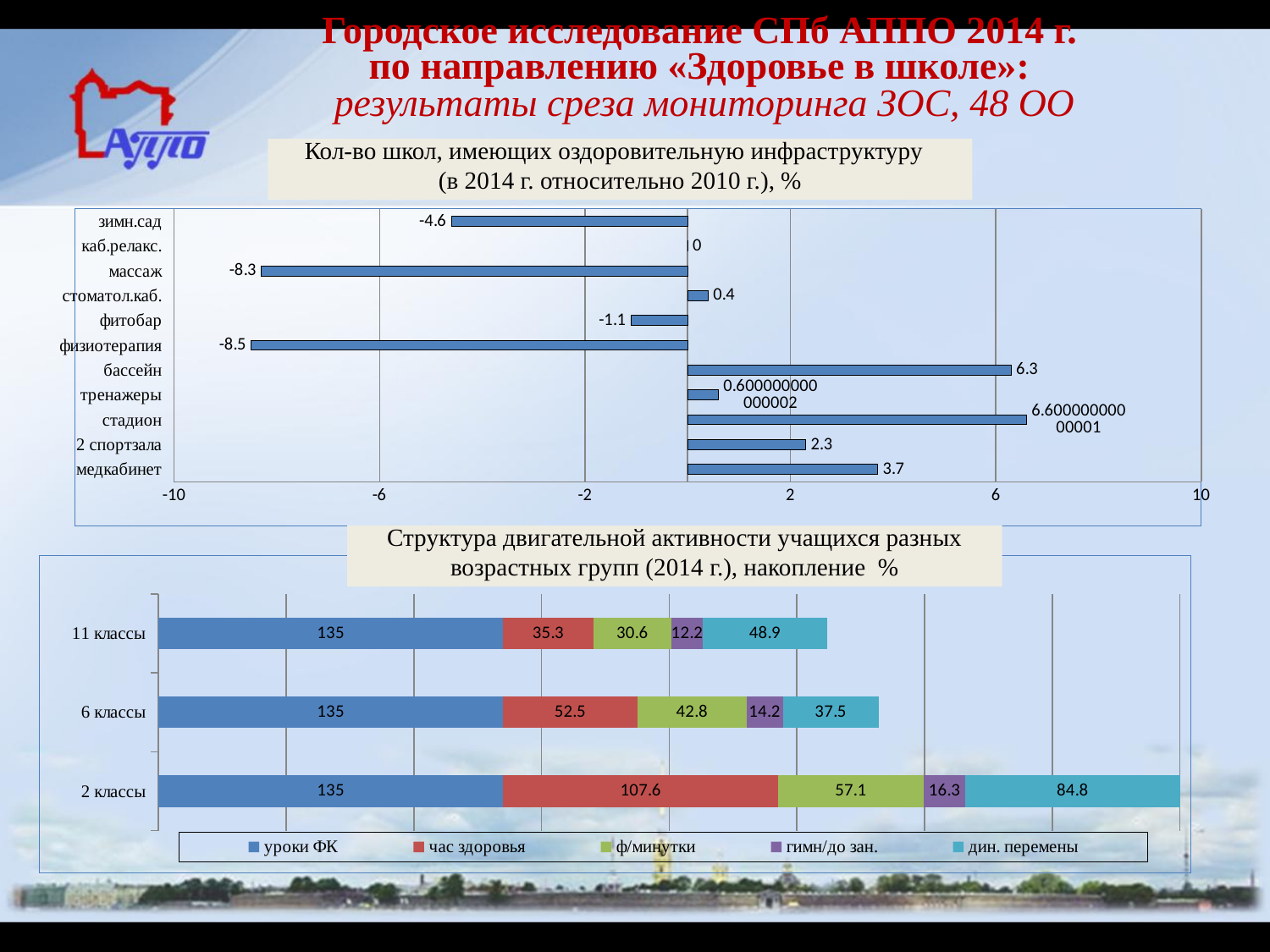
In the bottom chart (Структура двигательной активности учащихся), what is the total of the stacked bar for 6 классы? 282 In the bottom chart (Структура двигательной активности учащихся), what is the value of час здоровья for 2 классы? 107.6 In the top chart (Кол-во школ, имеющих оздоровительную инфраструктуру), how many categories are shown on the vertical axis? 11 In the top chart (Кол-во школ, имеющих оздоровительную инфраструктуру), what is the value for бассейн? 6.3 What kind of chart is the bottom chart (Структура двигательной активности учащихся)? Stacked bar chart In the bottom chart (Структура двигательной активности учащихся), which age group has the highest value for ф/минутки? 2 классы In the top chart (Кол-во школ, имеющих оздоровительную инфраструктуру), what is the value for медкабинет? 3.7 In the bottom chart (Структура двигательной активности учащихся), what is the value of дин. перемены for 11 классы? 48.9 In the top chart (Кол-во школ, имеющих оздоровительную инфраструктуру), what is the difference between the values for бассейн and 2 спортзала? 4 In the top chart (Кол-во школ, имеющих оздоровительную инфраструктуру), what is the value for массаж? -8.3 In the bottom chart (Структура двигательной активности учащихся), how many series does the legend list? 5 In the top chart (Кол-во школ, имеющих оздоровительную инфраструктуру), which is larger, the value for 2 спортзала or the value for медкабинет? медкабинет